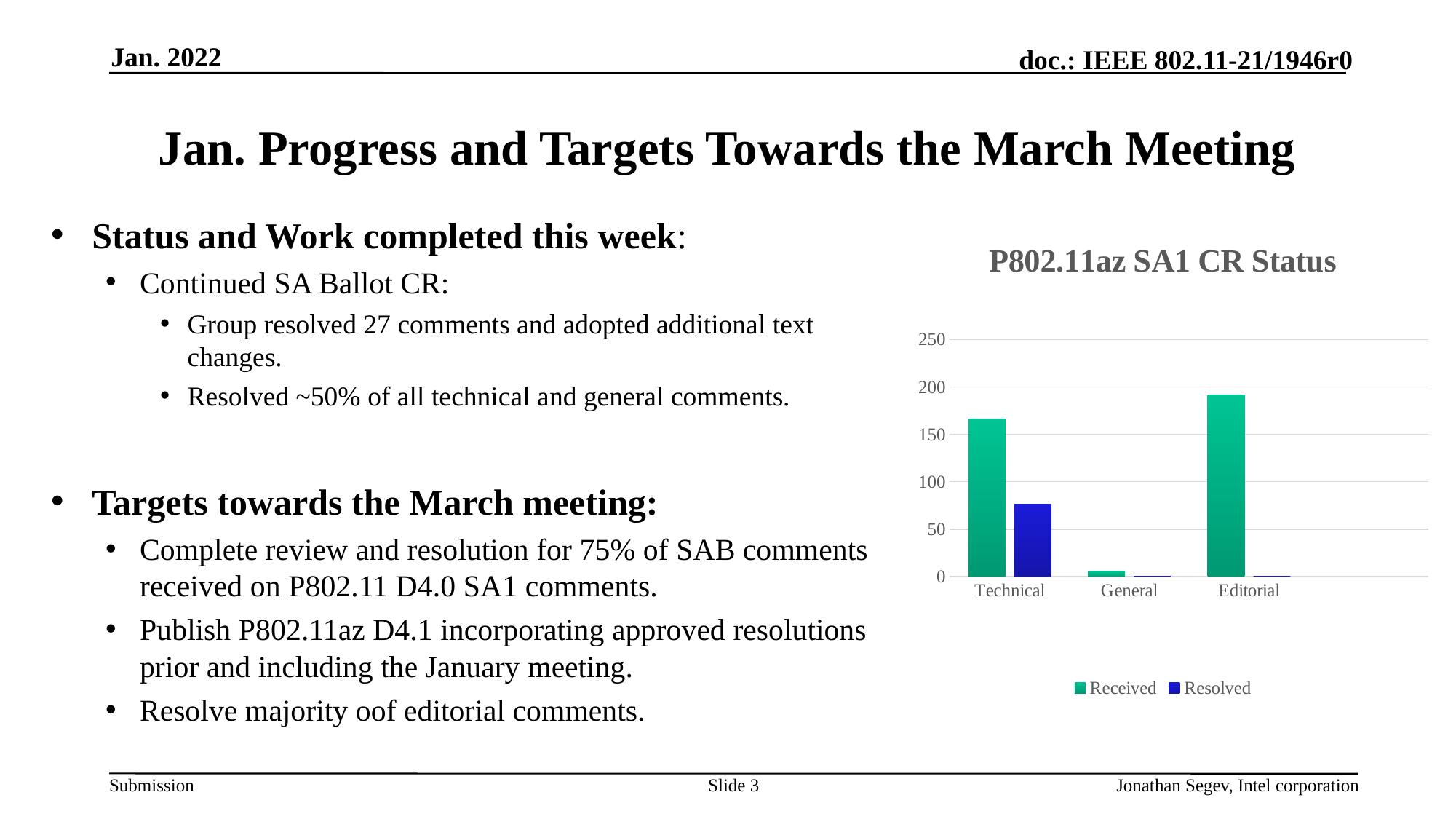
Which category has the highest Received value? Editorial Is the Received value for Technical greater or less than 150? greater Which category has the lowest Received value? General Which is larger, the Received value for Editorial or the Received value for Technical? Editorial Is the Received value for Editorial greater or less than 200? less What is the title of the chart? P802.11az SA1 CR Status What type of chart is shown on the slide? bar chart Which series is shown in blue in the chart legend? Resolved How many categories are shown on the x axis of the chart? 3 Is the Resolved value for Technical greater or less than 100? less How many series does the chart legend list? 2